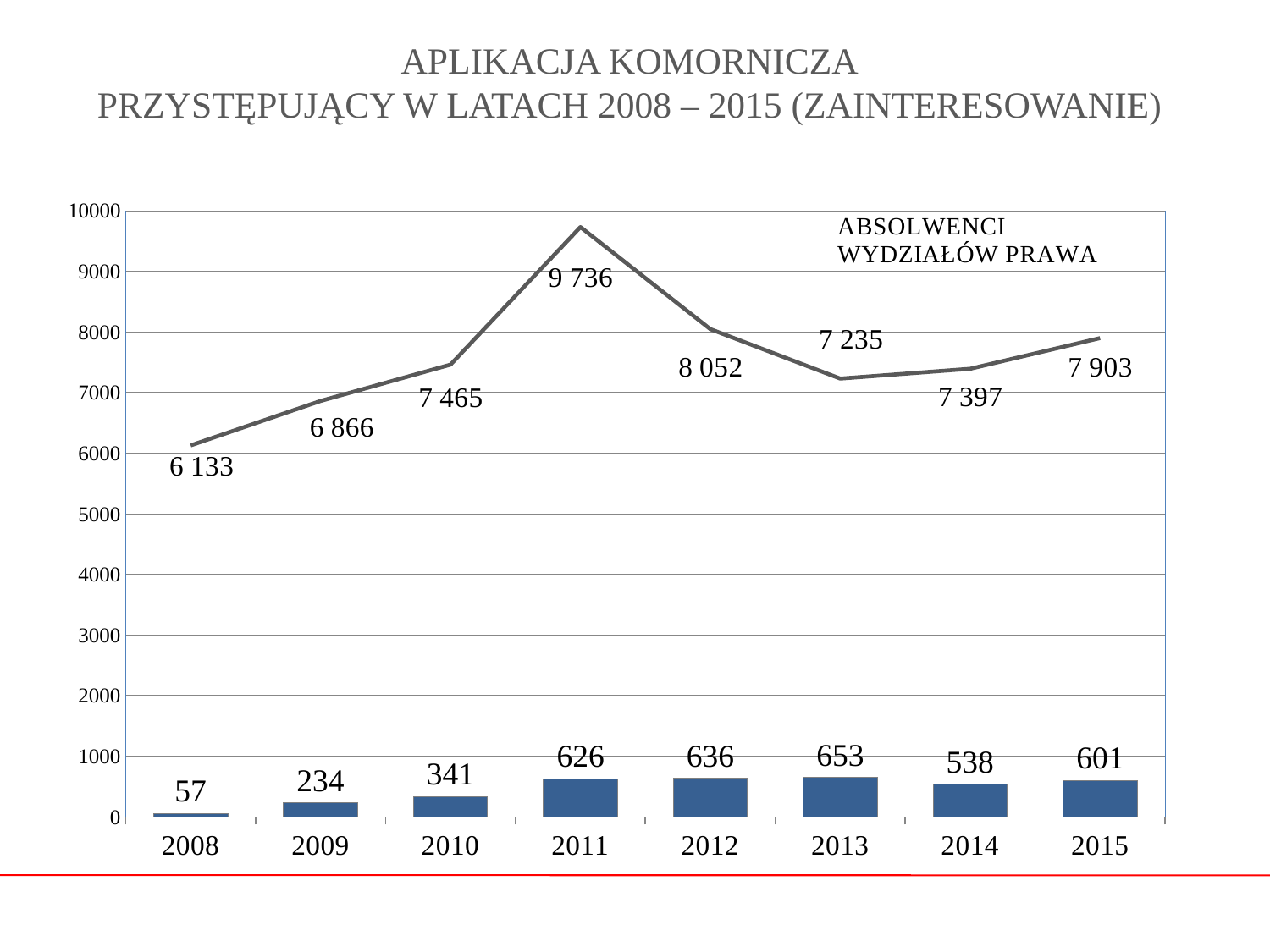
What is the value of the bar for 2011? 626 Which year has a larger bar value, 2010 or 2015? 2015 In which year is the bar value lowest? 2008 What is the difference between the bar values for 2013 and 2014? 115 What is the difference between the line values for 2011 and 2012? 1 684 In which year does the line (ABSOLWENCI WYDZIAŁÓW PRAWA) reach its highest value? 2011 What label is shown next to the line series? ABSOLWENCI WYDZIAŁÓW PRAWA In which year is the bar value highest? 2013 What is the value of the line (ABSOLWENCI WYDZIAŁÓW PRAWA) for 2013? 7 235 Is the line value for 2008 greater or less than 7000? less Do the bar values rise or fall from 2008 to 2011? rise How many years are shown on the x axis? 8